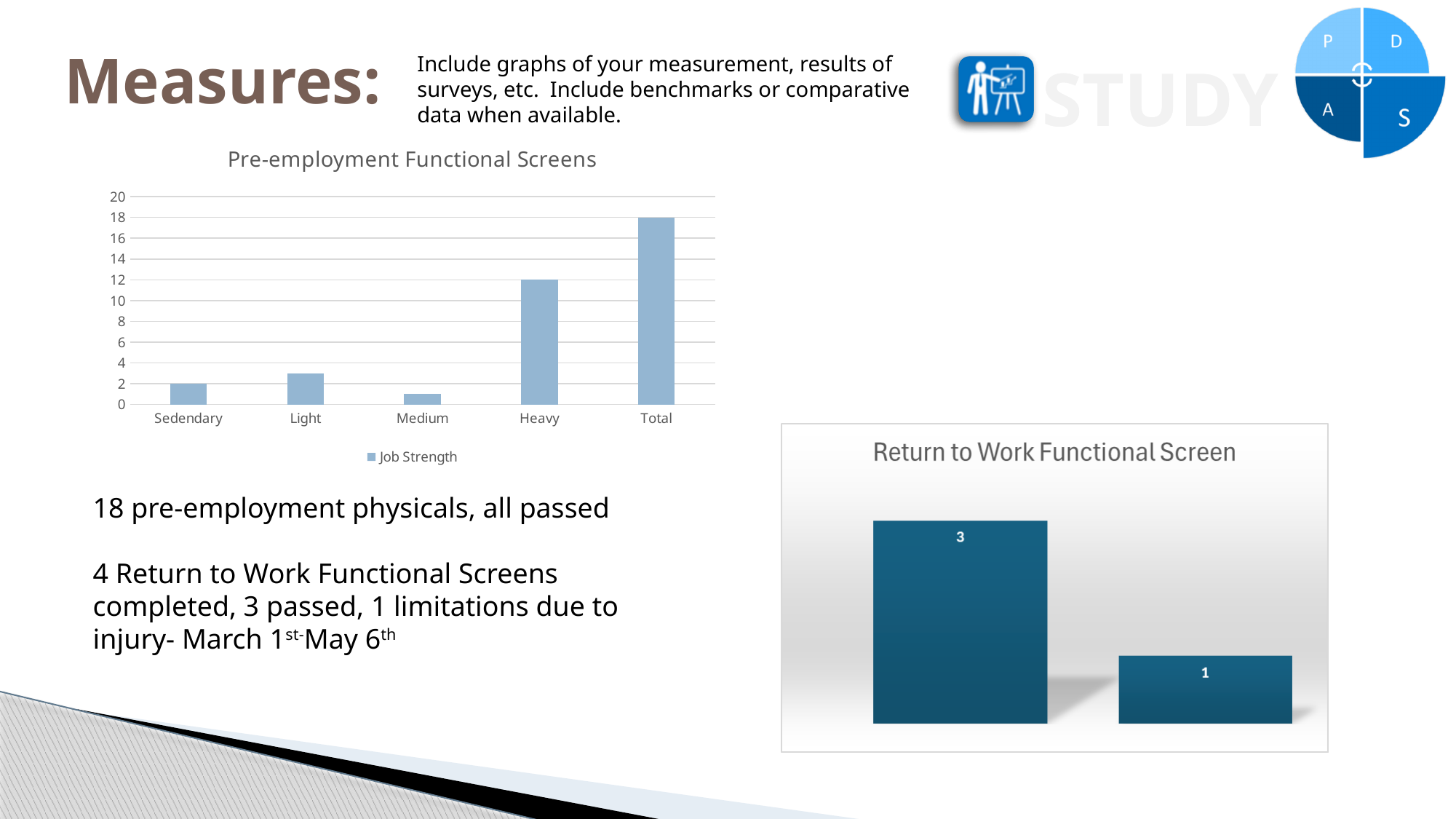
In the Pre-employment Functional Screens chart, which category has the lowest value? Medium In the Pre-employment Functional Screens chart, what series name does the legend show? Job Strength In the Pre-employment Functional Screens chart, what is the value for Sedendary? 2 In the Pre-employment Functional Screens chart, what is the value for Total? 18 In the Pre-employment Functional Screens chart, is the value for Medium greater or less than 2? less In the Return to Work Functional Screen chart, what is the value of the taller bar? 3 In the Return to Work Functional Screen chart, what is the difference between the two bars? 2 In the Pre-employment Functional Screens chart, what is the value for Heavy? 12 In the Pre-employment Functional Screens chart, which category has the highest value? Total In the Pre-employment Functional Screens chart, is the value for Light greater or less than 2? greater In the Pre-employment Functional Screens chart, how many categories are shown on the x axis? 5 In the Pre-employment Functional Screens chart, what is the difference between Total and Heavy? 6